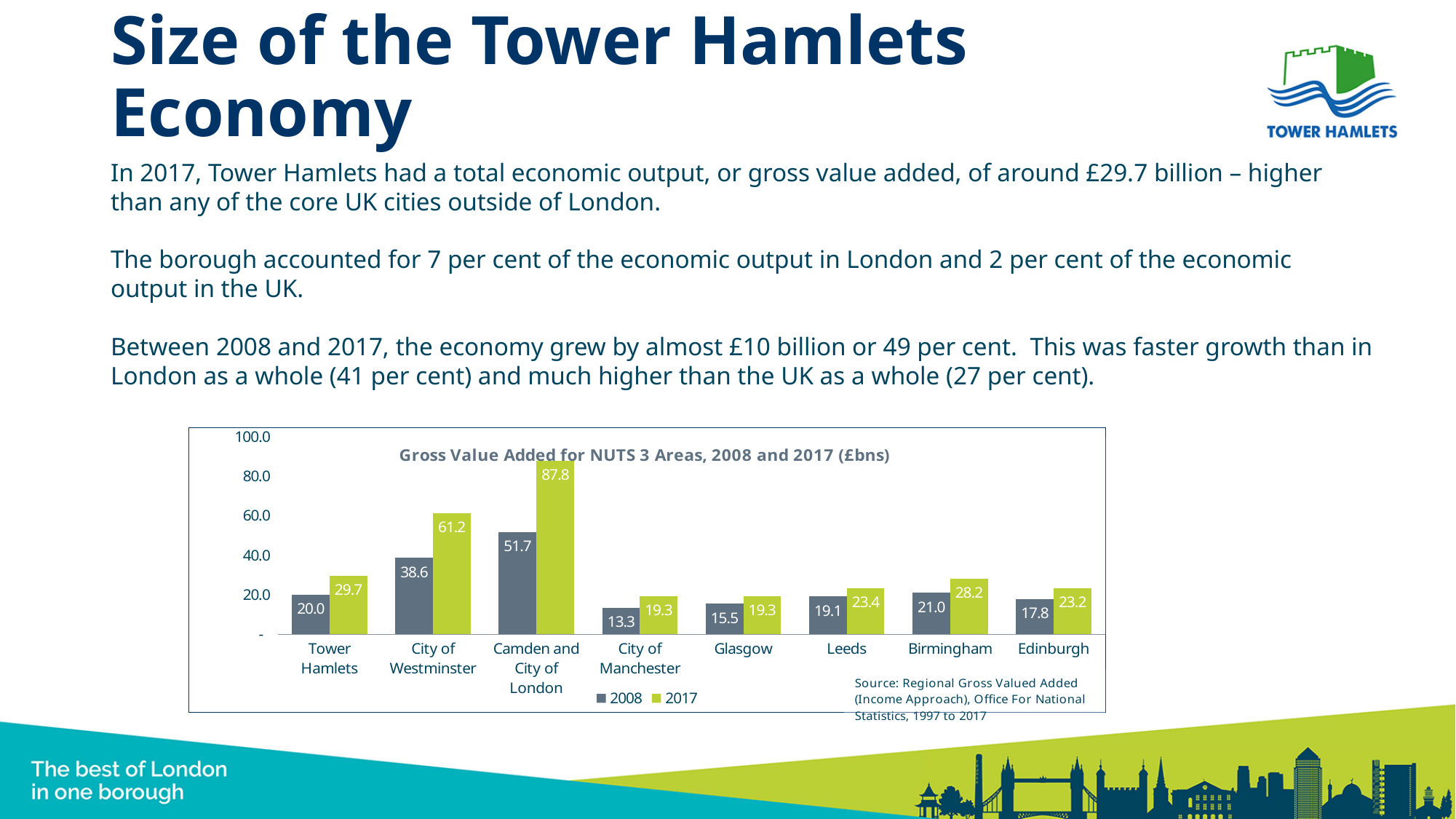
How many areas are shown on the x axis of the chart? 8 Which had the higher Gross Value Added in 2017, Birmingham or Leeds? Birmingham How many series does the chart legend list? 2 By how much did Tower Hamlets' Gross Value Added increase between 2008 and 2017? 9.7 What was the Gross Value Added for City of Westminster in 2008? 38.6 What is the title of the chart? Gross Value Added for NUTS 3 Areas, 2008 and 2017 (£bns) Which colour represents the 2017 series in the chart? Green What type of chart is shown on the slide? Bar chart What was the Gross Value Added for Tower Hamlets in 2017? 29.7 Which area had the lowest Gross Value Added in 2008? City of Manchester Which area had the highest Gross Value Added in 2017? Camden and City of London What is the difference between Camden and City of London's 2017 and 2008 Gross Value Added? 36.1